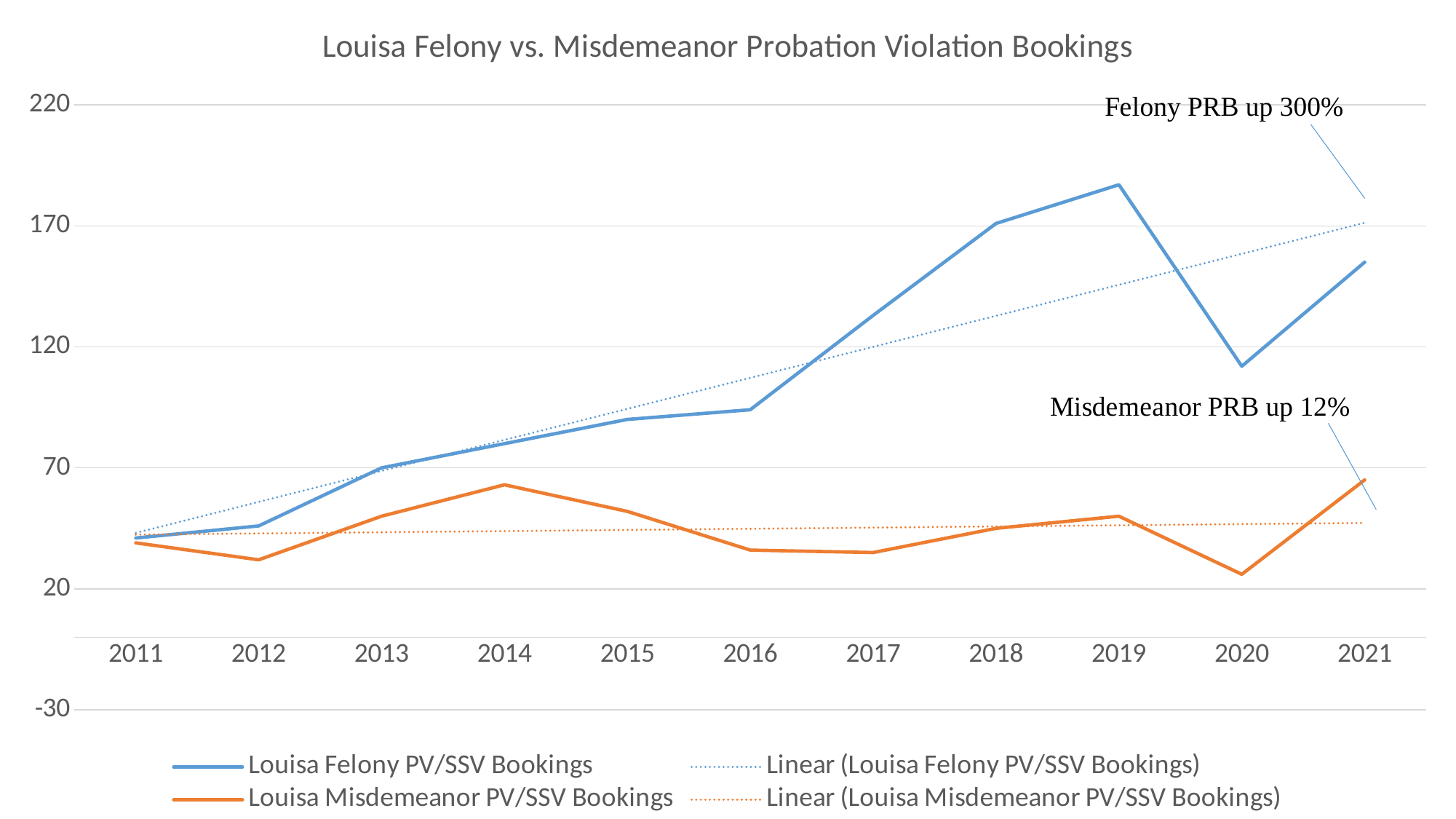
How many years are plotted along the x axis? 11 Is the value for Louisa Felony PV/SSV Bookings in 2020 greater or less than 120? less What is the title of the chart? Louisa Felony vs. Misdemeanor Probation Violation Bookings Is the value for Louisa Misdemeanor PV/SSV Bookings in 2014 greater or less than 70? less Which series has the larger value in 2019, Louisa Felony PV/SSV Bookings or Louisa Misdemeanor PV/SSV Bookings? Louisa Felony PV/SSV Bookings In which year do Louisa Misdemeanor PV/SSV Bookings reach their lowest value? 2020 In which year do Louisa Felony PV/SSV Bookings reach their highest value? 2019 Do Louisa Felony PV/SSV Bookings generally rise or fall from 2011 to 2019? rise Is the value for Louisa Felony PV/SSV Bookings in 2019 greater or less than 170? greater According to the annotation on the chart, by what percentage is Felony PRB up? 300% How many entries does the legend list? 4 What kind of chart is shown on the slide? line chart